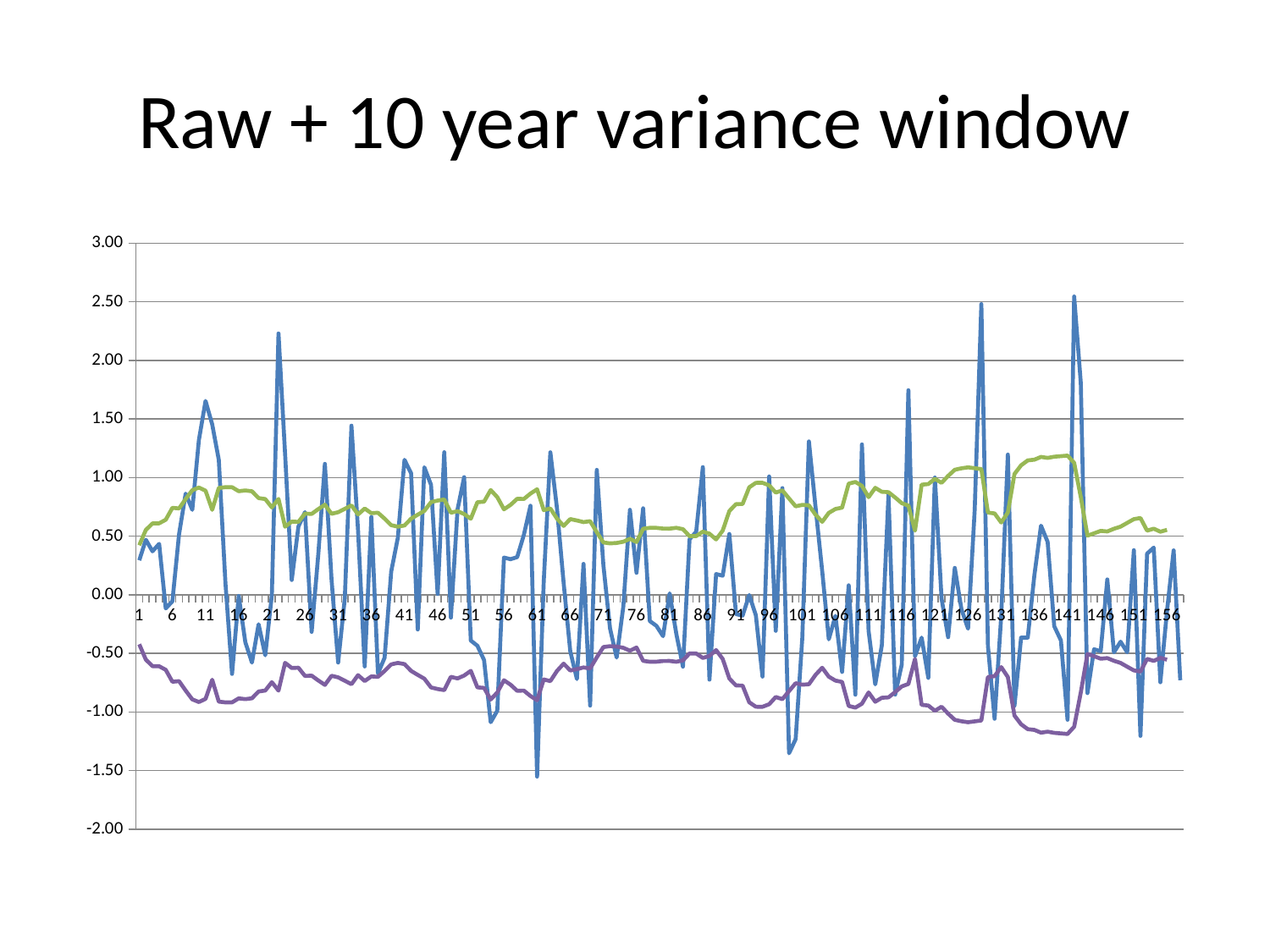
What is the last label shown on the horizontal axis? 156 Is the value of the purple line near x = 141 greater or less than -1.00? less Does the purple line ever rise above 0.00? No How many lines are plotted on the chart? 3 Is the lowest point of the blue line, near x = 61, greater or less than -1.00? less Which line reaches the highest value on the chart: the blue, green or purple line? blue What is the highest value shown on the vertical axis? 3.00 What kind of chart is shown on the slide? line chart What is the title of the chart? Raw + 10 year variance window